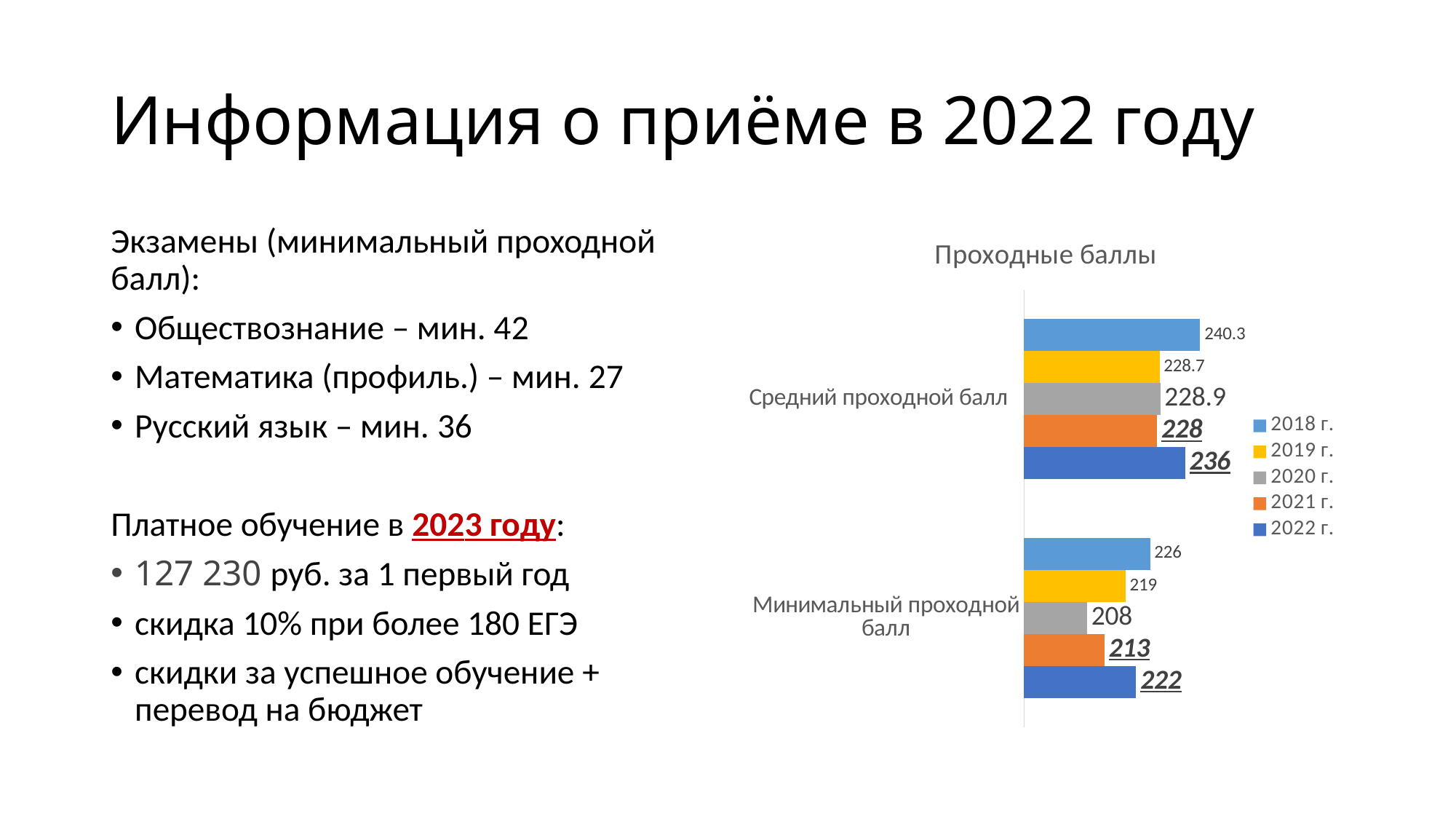
What is the title of the chart? Проходные баллы How many series does the legend list? 5 What is the difference between the 2018 г. and 2022 г. values in the Средний проходной балл category? 4.3 What is the value for 2018 г. in the Средний проходной балл category? 240.3 What kind of chart is shown on the slide? Bar chart Which year has the highest value in the Средний проходной балл category? 2018 г. What is the value for 2020 г. in the Минимальный проходной балл category? 208 Which year has the lowest value in the Минимальный проходной балл category? 2020 г. What is the difference between the 2022 г. and 2021 г. values in the Минимальный проходной балл category? 9 What is the value for 2021 г. in the Средний проходной балл category? 228 What is the value for 2022 г. in the Минимальный проходной балл category? 222 In the Минимальный проходной балл category, which is larger: the value for 2019 г. or for 2021 г.? 2019 г.